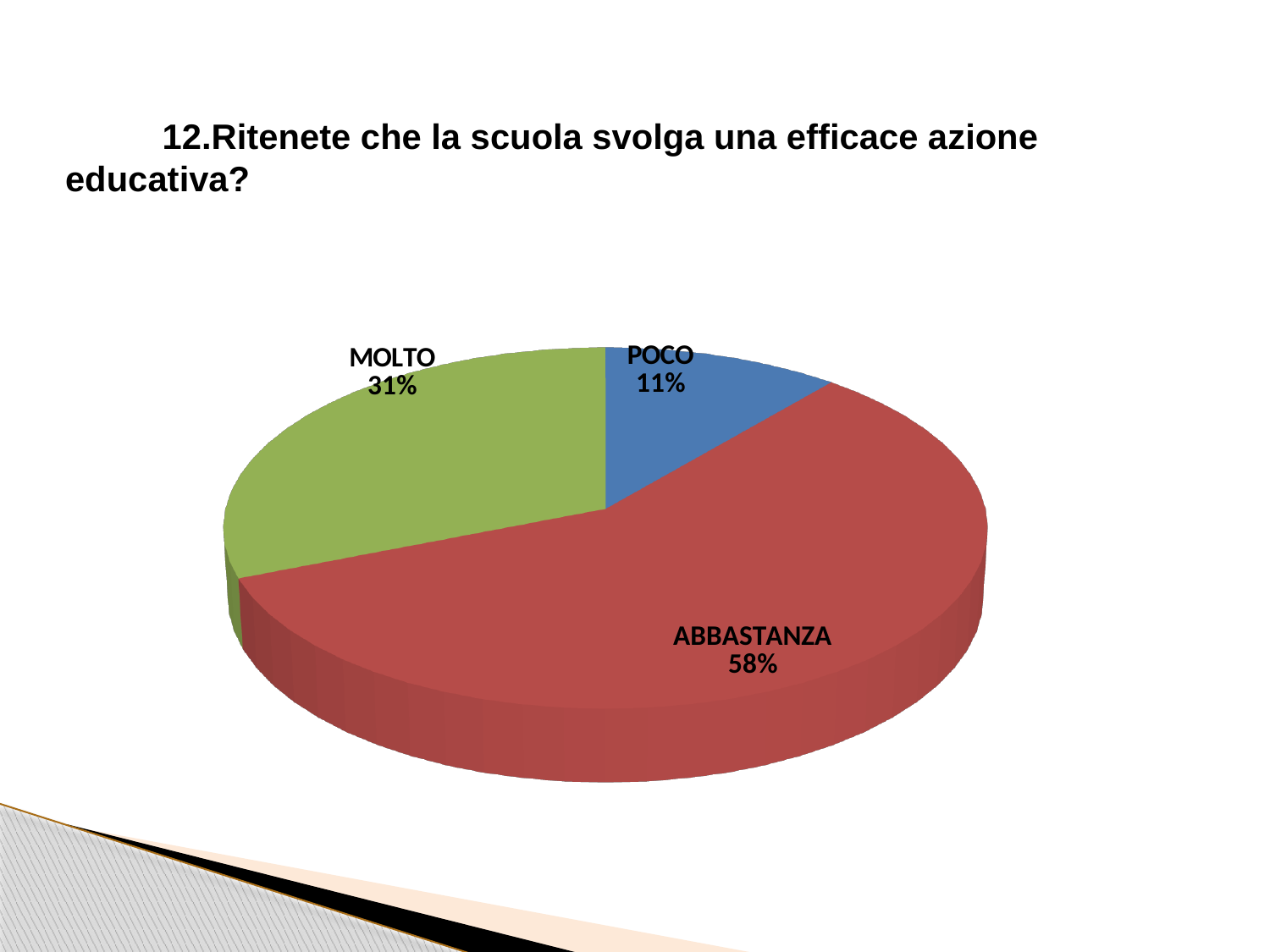
How many categories are shown in the pie chart? 3 Which category has the smallest slice of the pie? POCO What share of the pie does ABBASTANZA represent? 58% Which is larger, the share for MOLTO or the share for POCO? MOLTO What share of the pie does MOLTO represent? 31% What kind of chart is shown on the slide? Pie chart Which category has the largest slice of the pie? ABBASTANZA What colour is the POCO slice? Blue What colour is the ABBASTANZA slice? Red What is the difference in percentage points between MOLTO and POCO? 20 What is the difference in percentage points between ABBASTANZA and MOLTO? 27 What share of the pie does POCO represent? 11%